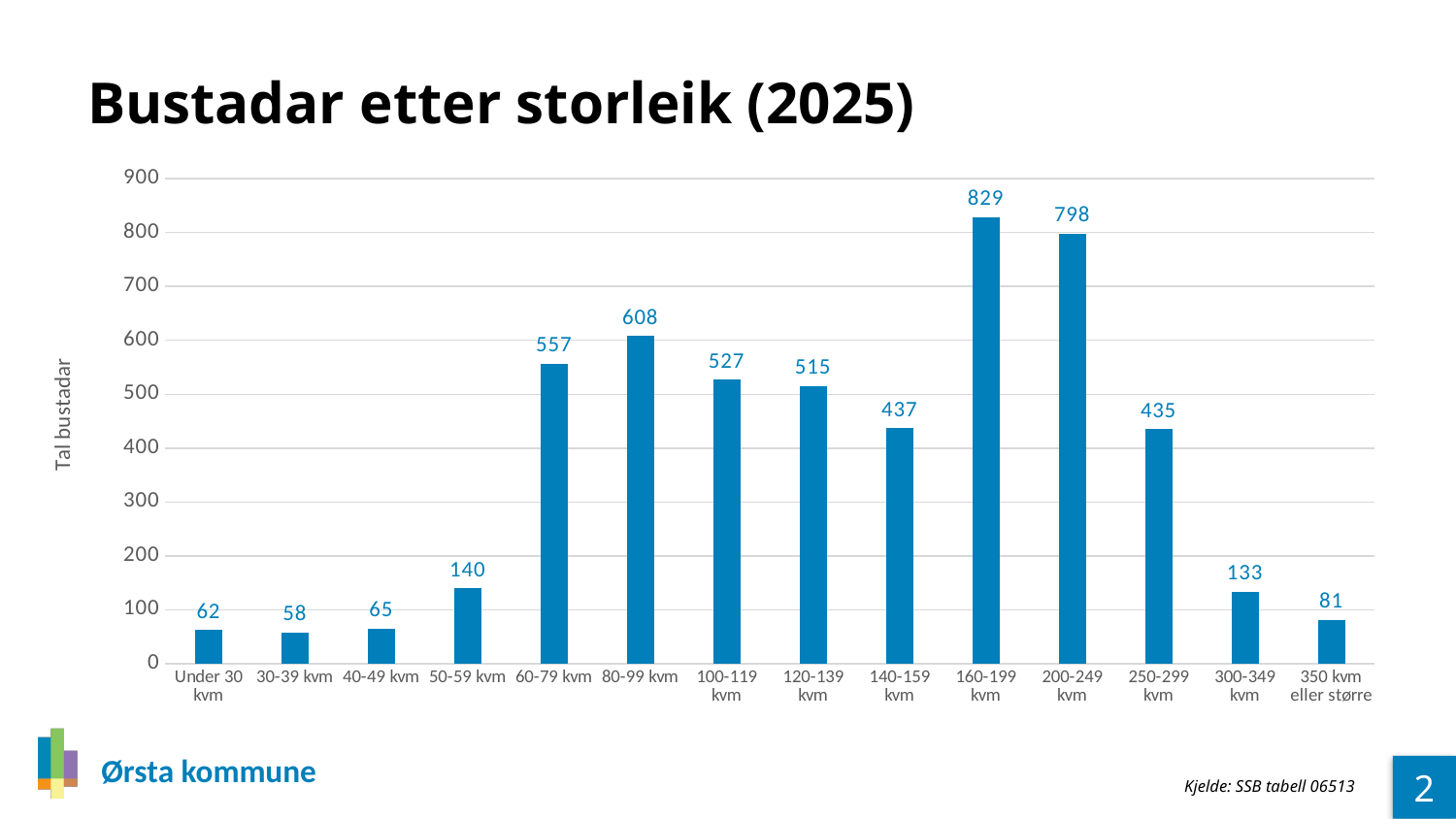
What is the difference between the values for 80-99 kvm and 60-79 kvm? 51 Which category has the highest value? 160-199 kvm How many dwellings are shown for the 50-59 kvm category? 140 What is the value for the 160-199 kvm category? 829 What is the title of the y axis? Tal bustadar What kind of chart is shown on the slide? Bar chart What is the value for the 350 kvm eller større category? 81 How many categories are shown on the x axis? 14 Is the value for 140-159 kvm greater or less than 400? greater Which category has the lowest value? 30-39 kvm Which is larger, the value for 100-119 kvm or the value for 120-139 kvm? 100-119 kvm What is the difference between the values for 160-199 kvm and 200-249 kvm? 31